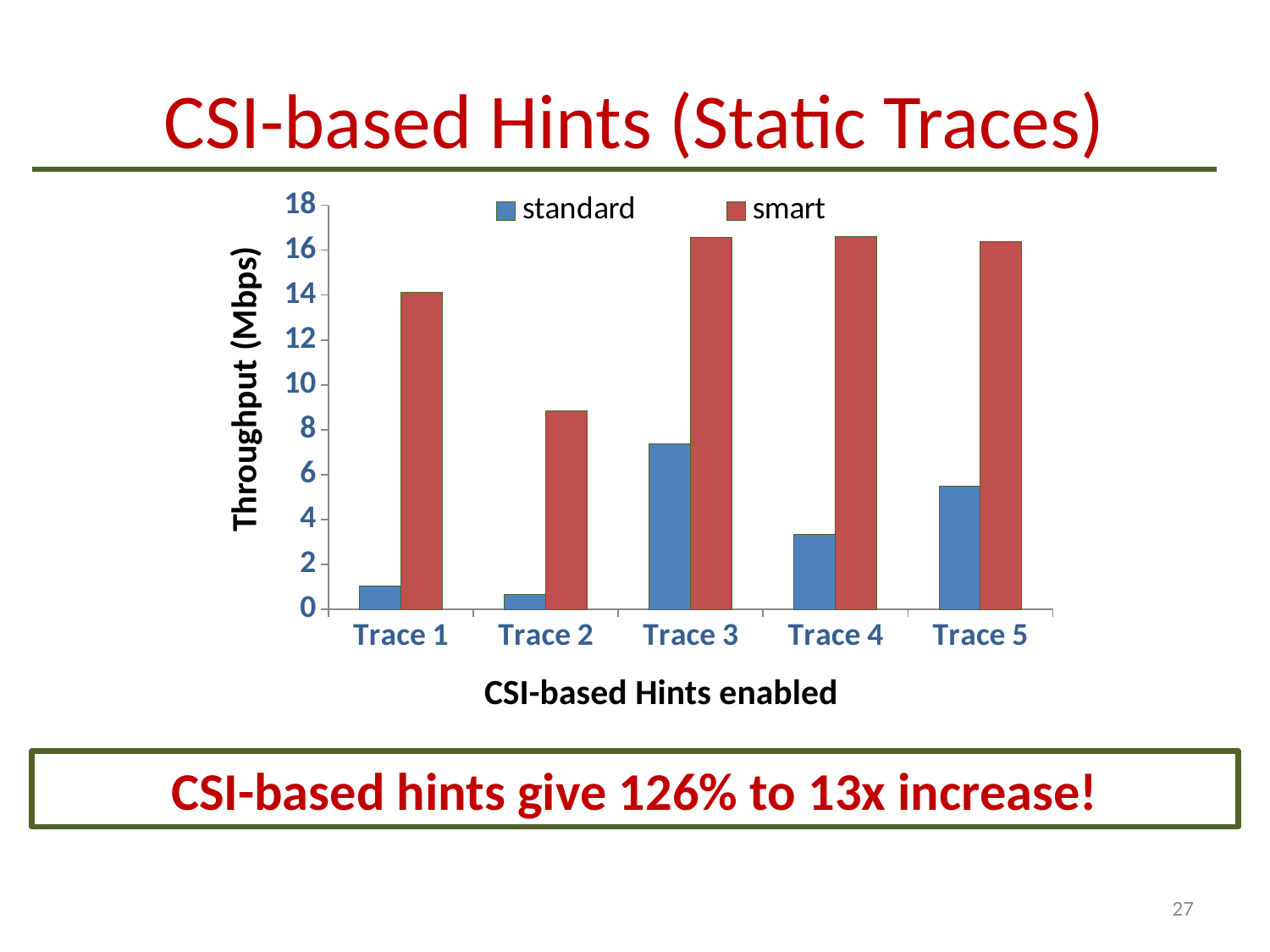
What is the label of the y axis? Throughput (Mbps) Is the smart throughput for Trace 2 greater or less than 10 Mbps? less Is the standard throughput for Trace 4 greater or less than 4 Mbps? less Is the standard throughput for Trace 3 greater or less than 6 Mbps? greater Which trace has the highest standard throughput? Trace 3 For Trace 5, which series has the larger throughput, standard or smart? smart Which trace has the lowest smart throughput? Trace 2 How many series does the legend list? 2 What kind of chart is shown on the slide? bar chart Which trace has the lowest standard throughput? Trace 2 How many traces are shown on the x axis? 5